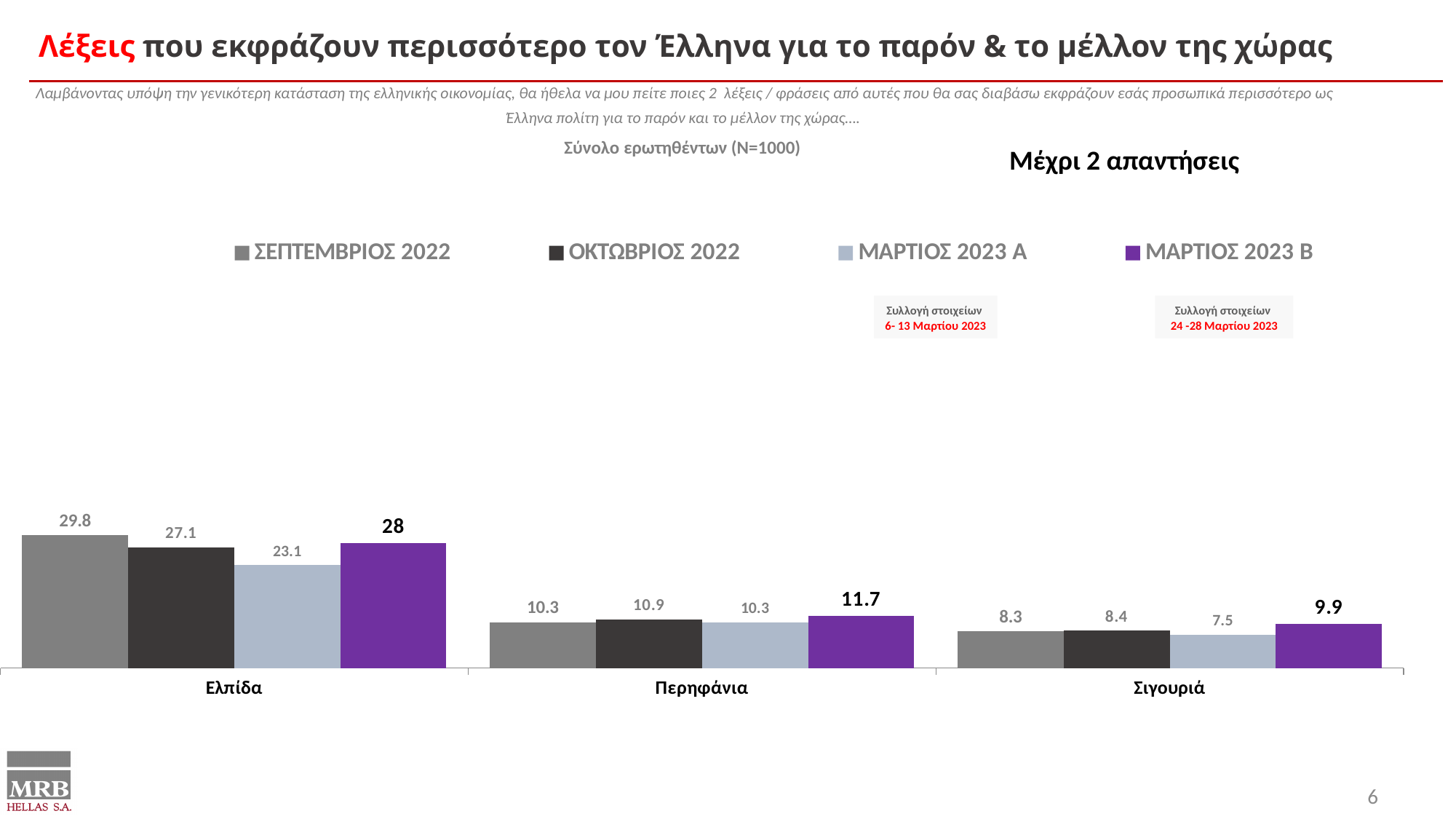
What is the value for Σιγουριά in the ΜΑΡΤΙΟΣ 2023 Α series? 7.5 What is the value for Ελπίδα in the ΜΑΡΤΙΟΣ 2023 Β series? 28 How many categories are shown on the x axis? 3 What is the value for Περηφάνια in the ΟΚΤΩΒΡΙΟΣ 2022 series? 10.9 How many series does the legend list? 4 What is the difference between the ΜΑΡΤΙΟΣ 2023 Β and ΜΑΡΤΙΟΣ 2023 Α values for Περηφάνια? 1.4 What kind of chart is shown on the slide? Bar chart Which is larger for Σιγουριά: the ΟΚΤΩΒΡΙΟΣ 2022 value or the ΜΑΡΤΙΟΣ 2023 Β value? ΜΑΡΤΙΟΣ 2023 Β Which category has the highest value in the ΣΕΠΤΕΜΒΡΙΟΣ 2022 series? Ελπίδα What is the difference between the ΣΕΠΤΕΜΒΡΙΟΣ 2022 and ΜΑΡΤΙΟΣ 2023 Α values for Ελπίδα? 6.7 Which category has the lowest value in the ΜΑΡΤΙΟΣ 2023 Β series? Σιγουριά Which series is shown in purple in the legend? ΜΑΡΤΙΟΣ 2023 Β